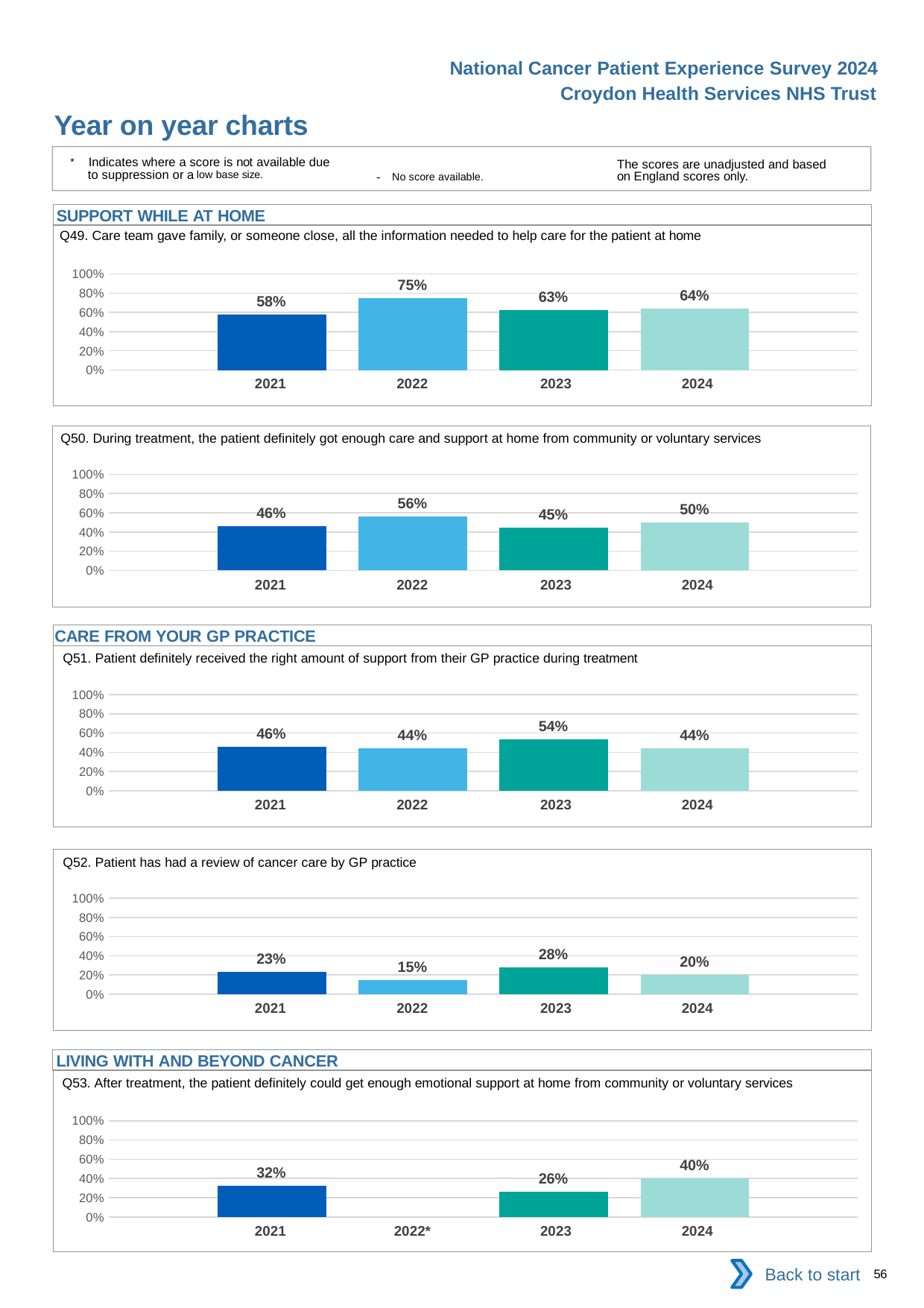
In the Q52 chart, what is the value for 2022? 15% In the Q50 chart, what is the value for 2024? 50% How many years are shown on the x axis of the Q49 chart? 4 In the Q51 chart, is the value for 2021 larger or smaller than the value for 2023? smaller In the Q50 chart, what is the difference between the 2022 and 2023 values? 11% In the Q51 chart, which year has the highest value? 2023 In the Q53 chart, what is the value for 2024? 40% In the Q52 chart, what is the difference between the 2023 and 2021 values? 5% In the Q53 chart, which year has no bar shown? 2022* What type of chart is used for Q52? bar chart In the Q49 chart, which year has the lowest value? 2021 In the Q49 chart, what is the value for 2022? 75%